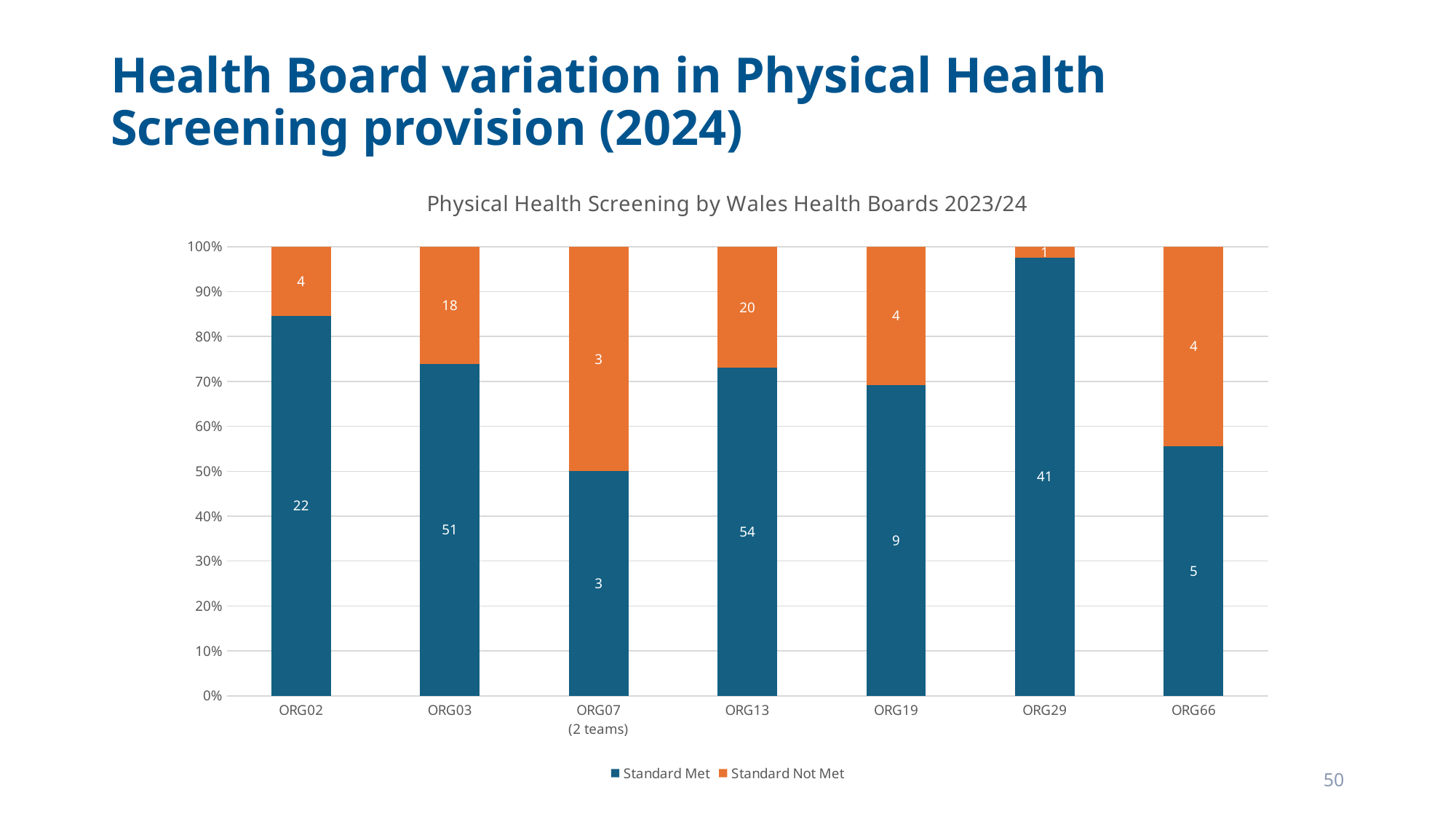
What is the Standard Met value for ORG13? 54 What is the Standard Met value for ORG29? 41 How many health boards are shown on the x axis? 7 Which is larger, the Standard Met count for ORG02 or for ORG19? ORG02 Is the Standard Met share of the ORG29 bar greater or less than 90%? greater Which health board has the lowest Standard Not Met count? ORG29 What kind of chart is shown on the slide? Stacked bar chart Which health board has the highest Standard Met count? ORG13 What is the total count (Standard Met plus Standard Not Met) for ORG02? 26 What is the Standard Not Met value for ORG03? 18 How many series does the legend list? 2 What is the difference between the Standard Met and Standard Not Met counts for ORG03? 33